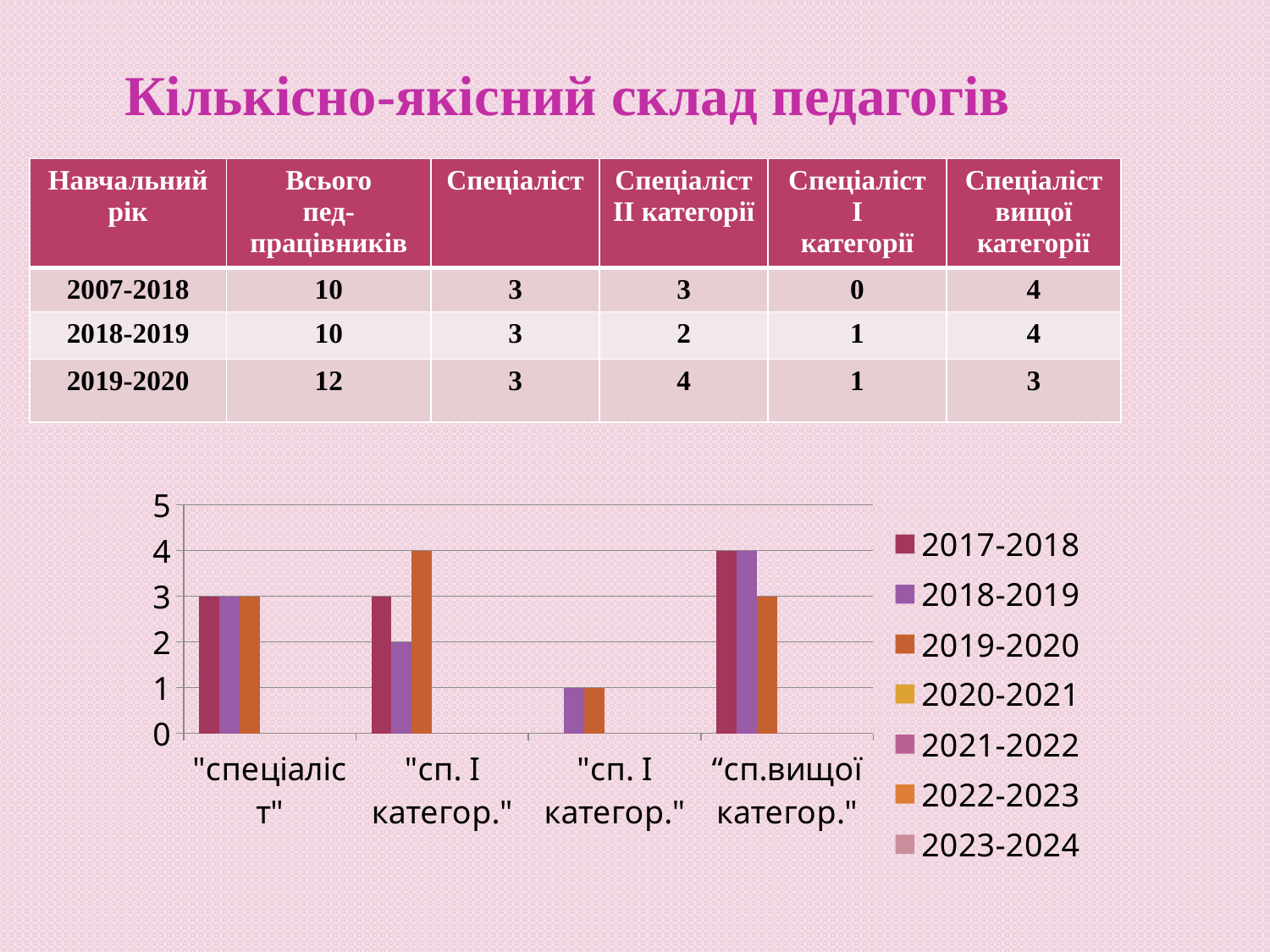
How many of the legend series actually have bars plotted in the chart? 3 In the "сп.вищої категор." category, which series has the lowest value? 2019-2020 What is the value for the 2019-2020 series in the "сп.вищої категор." category? 3 What kind of chart is shown on the slide? bar chart How many categories are shown on the x axis of the chart? 4 In the second category from the left, which is larger: the 2018-2019 bar or the 2019-2020 bar? 2019-2020 Is the value for the 2019-2020 series in the second category from the left greater or less than 3? greater What is the value for the 2018-2019 series in the "спеціаліст" category? 3 What is the value for the 2017-2018 series in the "сп.вищої категор." category? 4 What is the title of the slide? Кількісно-якісний склад педагогів In the "сп.вищої категор." category, what is the difference between the 2017-2018 value and the 2019-2020 value? 1 How many series does the chart legend list? 7